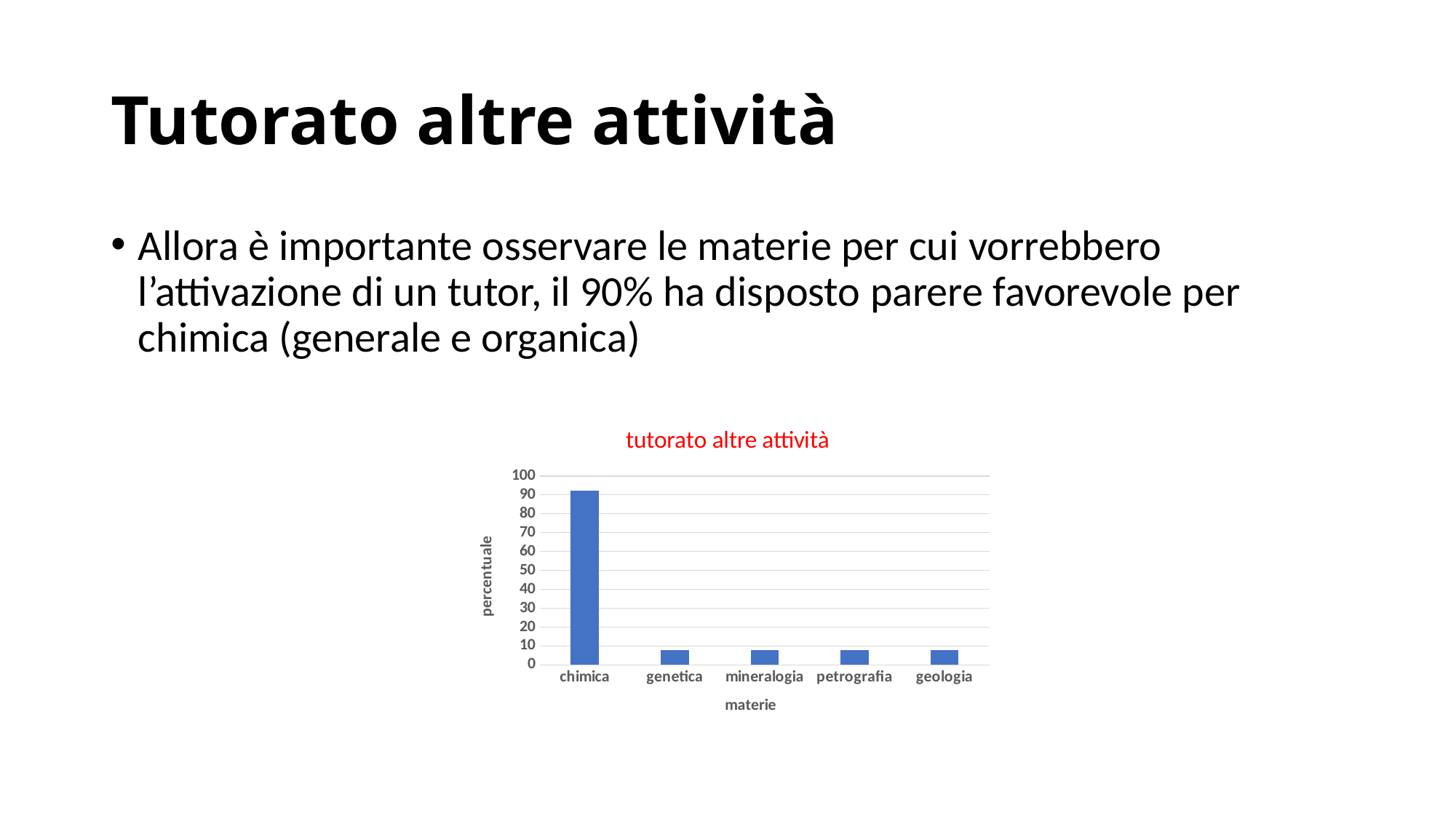
Is the value for genetica greater or less than 10? less What kind of chart is shown on the slide? bar chart What is the title of the chart? tutorato altre attività What is the label of the vertical axis of the chart? percentuale Is the value for mineralogia greater or less than 20? less How many categories (materie) are shown on the x axis of the chart? 5 Which is larger, the value for chimica or the value for geologia? chimica Which is larger, the value for chimica or the value for petrografia? chimica Is the value for chimica greater or less than 80? greater Which category has the highest value in the chart? chimica